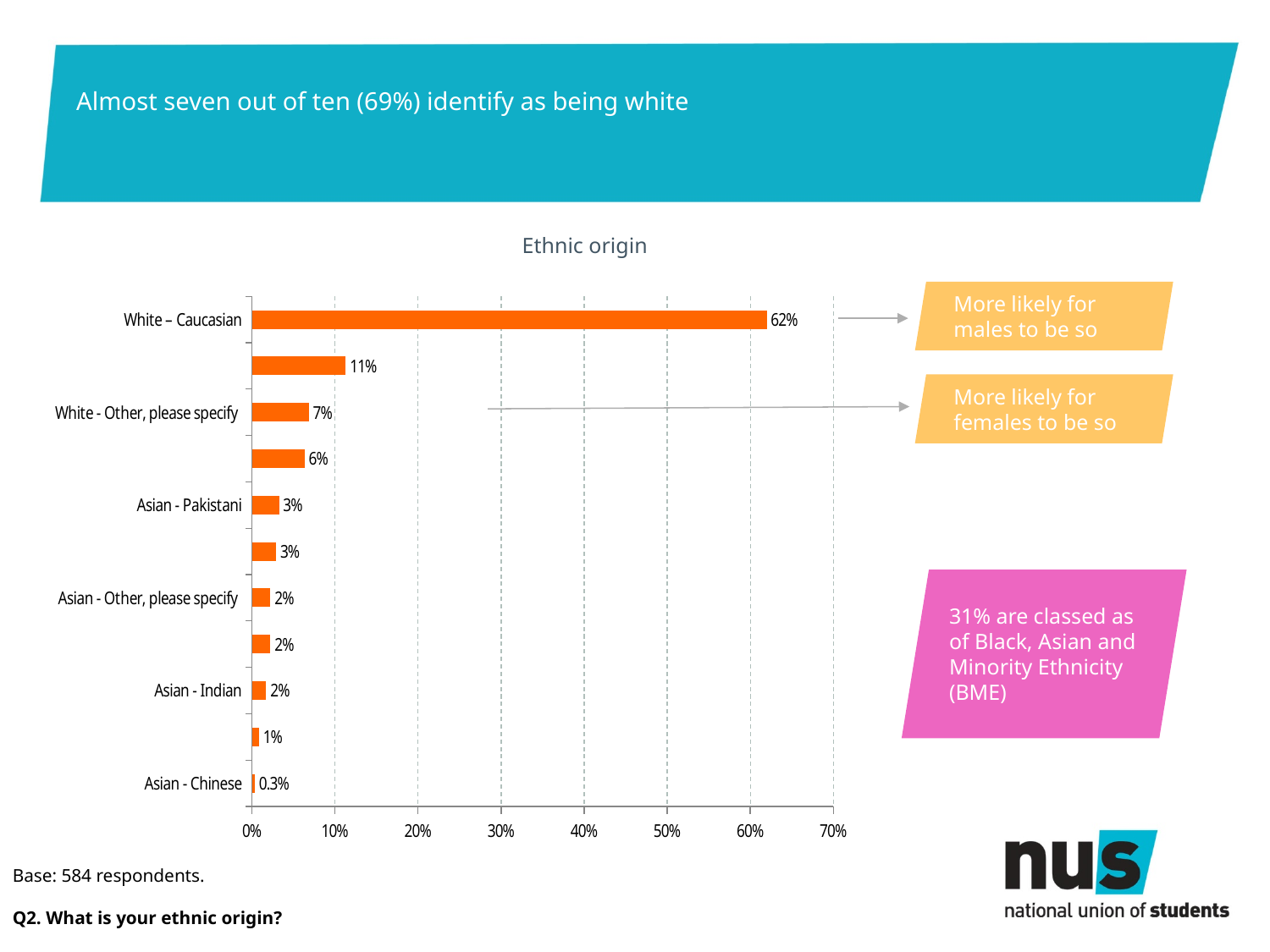
What is the value for White - Other, please specify? 7% What is the value for Asian - Chinese? 0.3% What is the difference between the values for White – Caucasian and White - Other, please specify? 55 percentage points What kind of chart is shown on the slide? Bar chart What is the value for White – Caucasian? 62% Which category has the highest value? White – Caucasian Which is larger, the value for Asian - Pakistani or the value for Asian - Indian? Asian - Pakistani How many bars are plotted in the chart? 11 What is the title of the chart? Ethnic origin Which category has the lowest value? Asian - Chinese What is the value for Asian - Pakistani? 3% What is the value for Asian - Indian? 2%